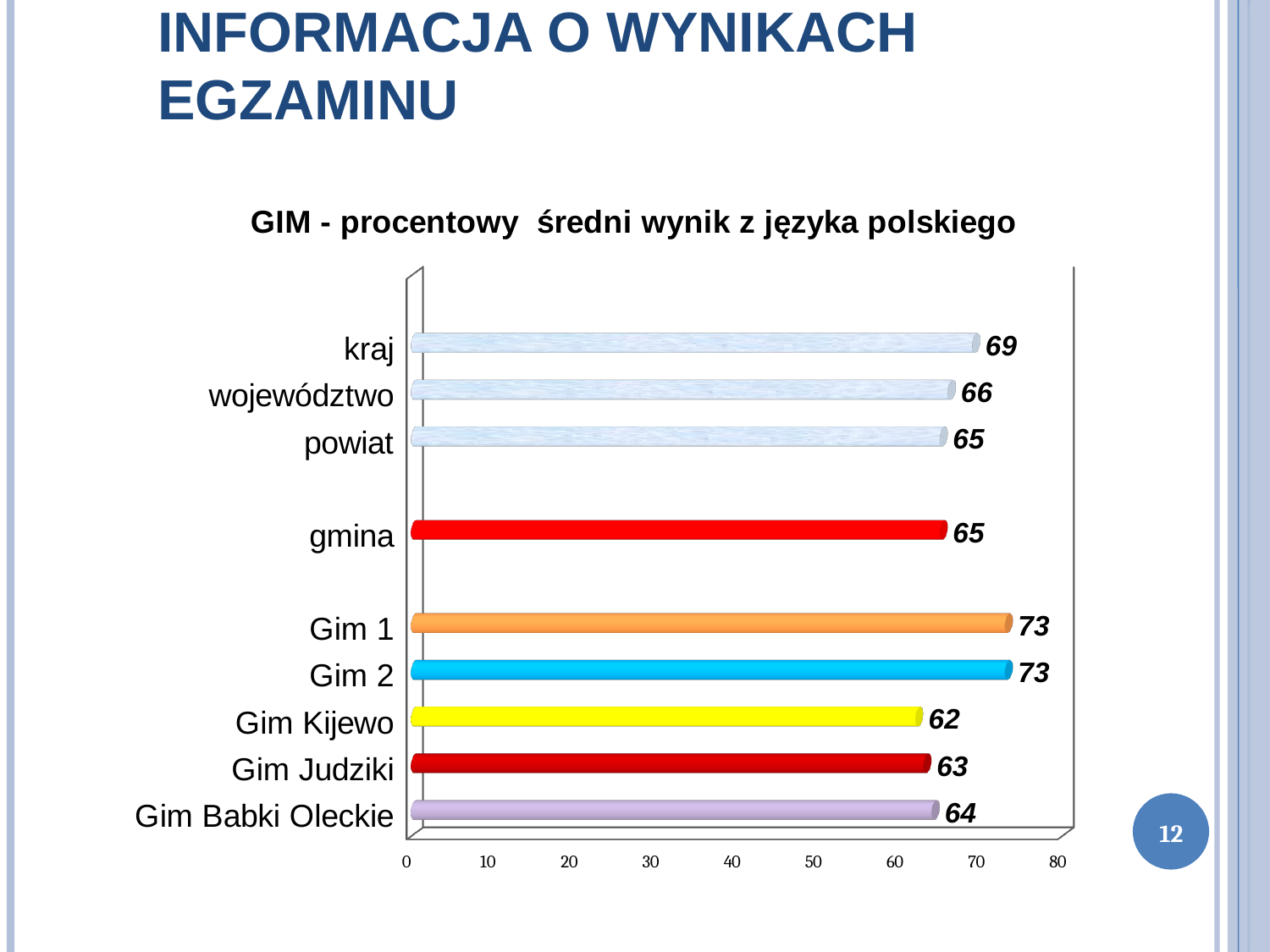
What is the value for kraj? 69 Which is larger, the value for kraj or the value for powiat? kraj What is the title of the chart? GIM - procentowy średni wynik z języka polskiego What is the difference between the values for Gim 1 and Gim Judziki? 10 What kind of chart is shown on the slide? bar chart What is the value for Gim Babki Oleckie? 64 What is the difference between the values for kraj and województwo? 3 How many categories are shown in the chart? 9 Which category has the lowest value? Gim Kijewo What is the value for Gim Kijewo? 62 Which is larger, the value for Gim Judziki or the value for Gim Babki Oleckie? Gim Babki Oleckie What is the value for gmina? 65